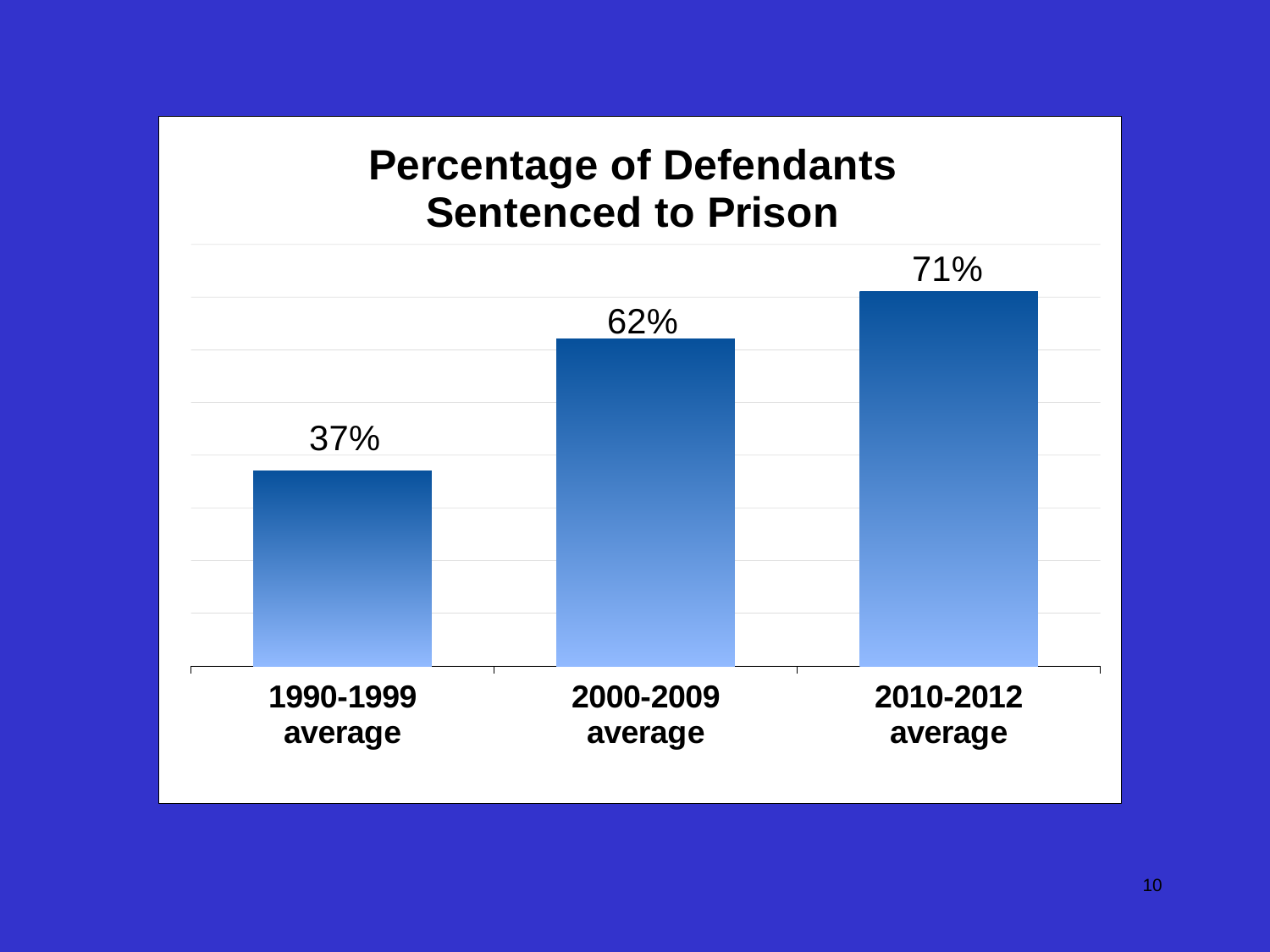
What is the difference in percentage points between the 2000-2009 average and the 1990-1999 average? 25 How many periods are shown in the chart? 3 What kind of chart is shown on the slide? Bar chart Do the values rise or fall from the 1990-1999 average to the 2010-2012 average? Rise What is the percentage of defendants sentenced to prison for the 2010-2012 average? 71% Which period has the highest percentage of defendants sentenced to prison? 2010-2012 average What is the difference in percentage points between the 2010-2012 average and the 1990-1999 average? 34 What is the title of the chart? Percentage of Defendants Sentenced to Prison Which period has the lowest percentage of defendants sentenced to prison? 1990-1999 average Which is larger, the 2000-2009 average or the 2010-2012 average? 2010-2012 average What is the percentage of defendants sentenced to prison for the 2000-2009 average? 62% What is the percentage of defendants sentenced to prison for the 1990-1999 average? 37%